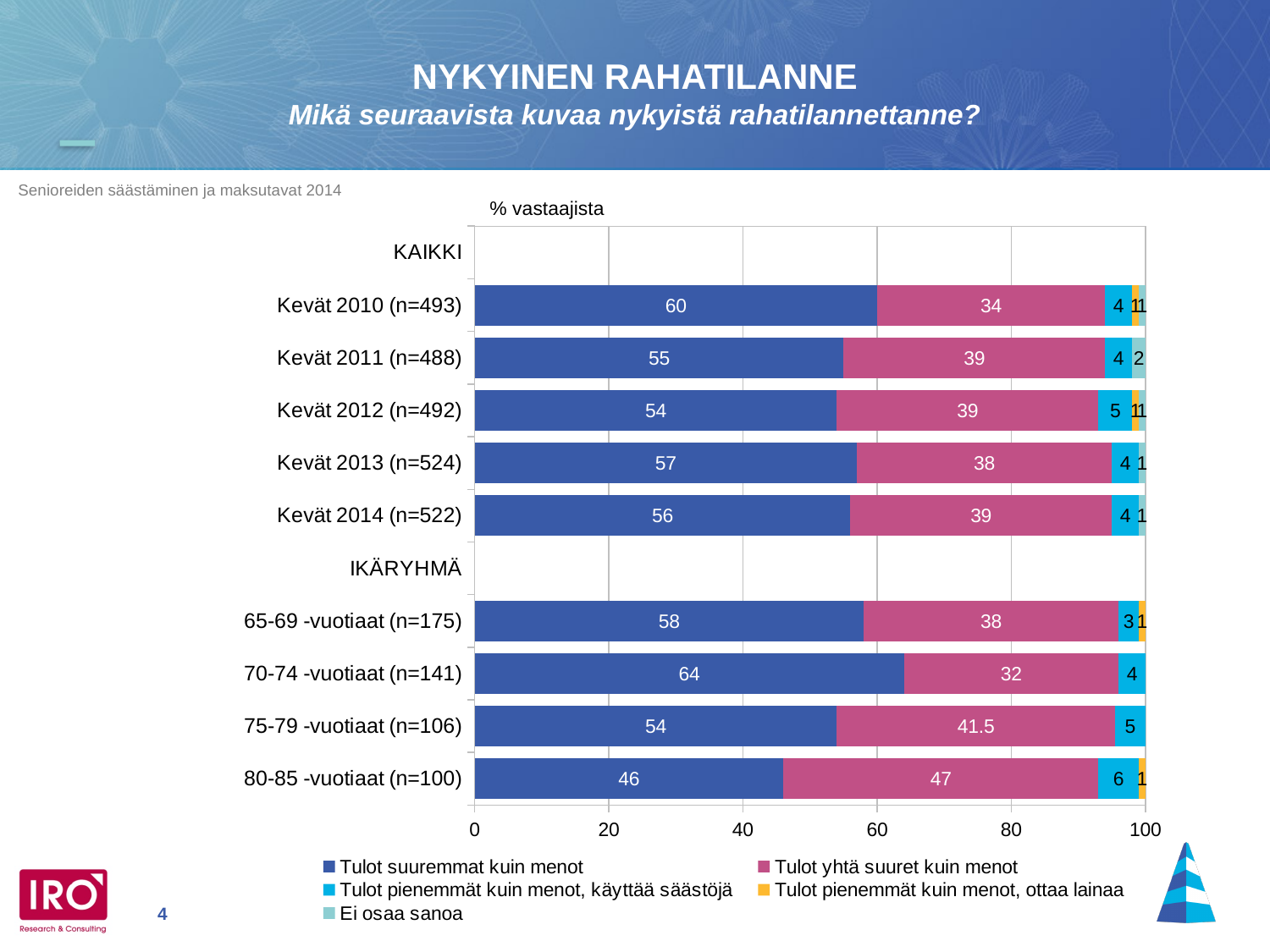
Which category has the highest value for 'Tulot suuremmat kuin menot'? 70-74 -vuotiaat (n=141) What is the value of 'Tulot yhtä suuret kuin menot' for 75-79 -vuotiaat (n=106)? 41.5 Which is larger for 80-85 -vuotiaat (n=100): 'Tulot suuremmat kuin menot' or 'Tulot yhtä suuret kuin menot'? Tulot yhtä suuret kuin menot What is the value of 'Tulot pienemmät kuin menot, käyttää säästöjä' for 80-85 -vuotiaat (n=100)? 6 How many series does the legend list? 5 What is the value of 'Tulot yhtä suuret kuin menot' for Kevät 2014 (n=522)? 39 What type of chart is shown on the slide? stacked bar chart Which category has the lowest value for 'Tulot suuremmat kuin menot'? 80-85 -vuotiaat (n=100) Which category has the highest value for 'Tulot yhtä suuret kuin menot'? 80-85 -vuotiaat (n=100) What is the value of 'Tulot suuremmat kuin menot' for Kevät 2010 (n=493)? 60 What is the difference between the 'Tulot suuremmat kuin menot' values for Kevät 2010 (n=493) and Kevät 2011 (n=488)? 5 What is the axis label shown above the chart? % vastaajista